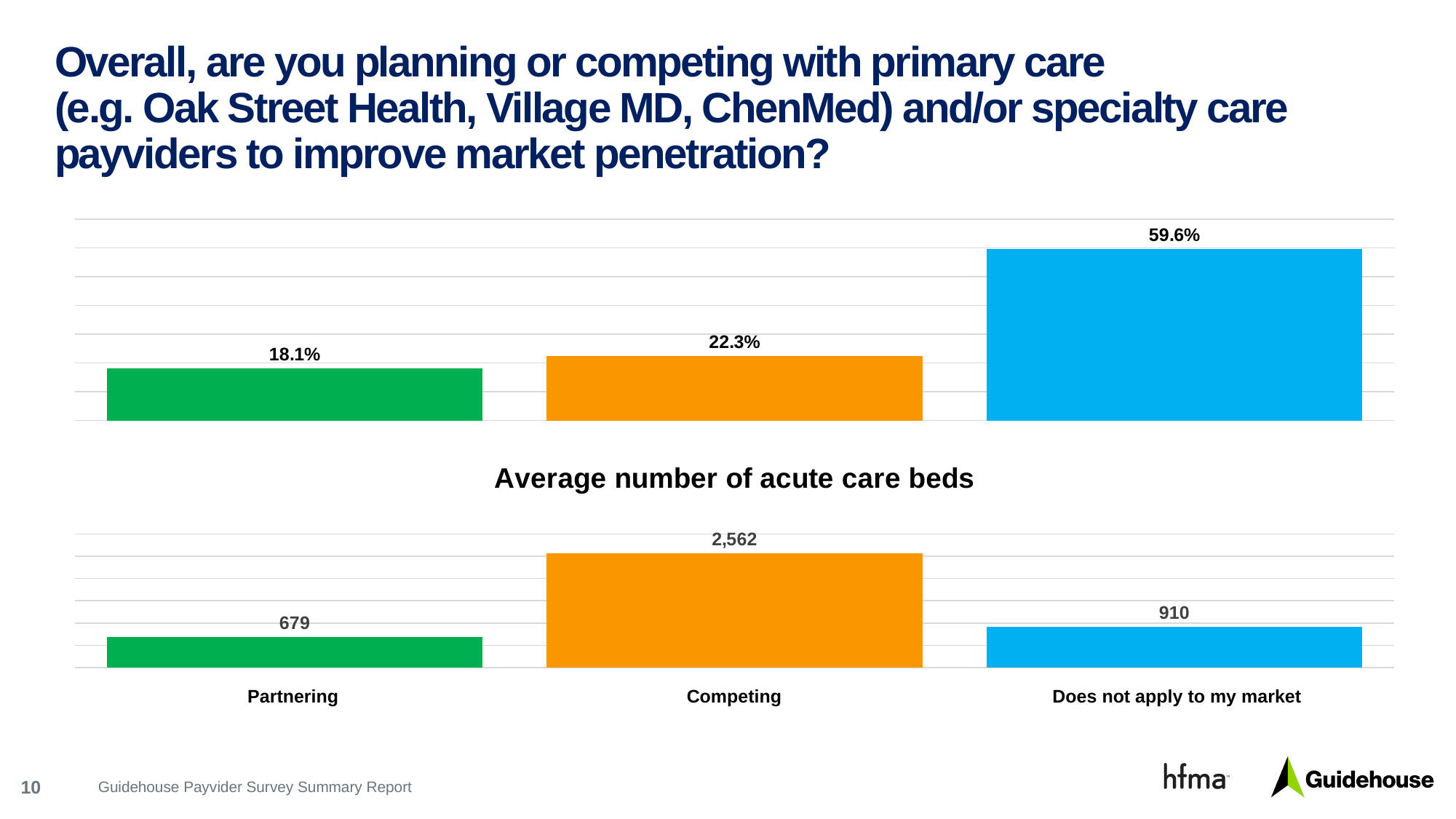
In the bottom chart titled 'Average number of acute care beds', what is the value for Does not apply to my market? 910 In the bottom chart titled 'Average number of acute care beds', what is the value for Competing? 2,562 In the bottom chart titled 'Average number of acute care beds', what is the difference between Competing and Partnering? 1,883 In the bottom chart titled 'Average number of acute care beds', which is larger: Partnering or Does not apply to my market? Does not apply to my market In the top chart, which category has the highest percentage? Does not apply to my market What type of chart is the bottom chart titled 'Average number of acute care beds'? Bar chart In the top chart, which category has the lowest percentage? Partnering In the bottom chart titled 'Average number of acute care beds', which category has the lowest value? Partnering In the top chart, what percentage of respondents selected Competing? 22.3% In the top chart, what is the difference in percentage points between Does not apply to my market and Competing? 37.3 In the top chart, what percentage of respondents selected Partnering? 18.1% How many categories are shown in the top chart? 3